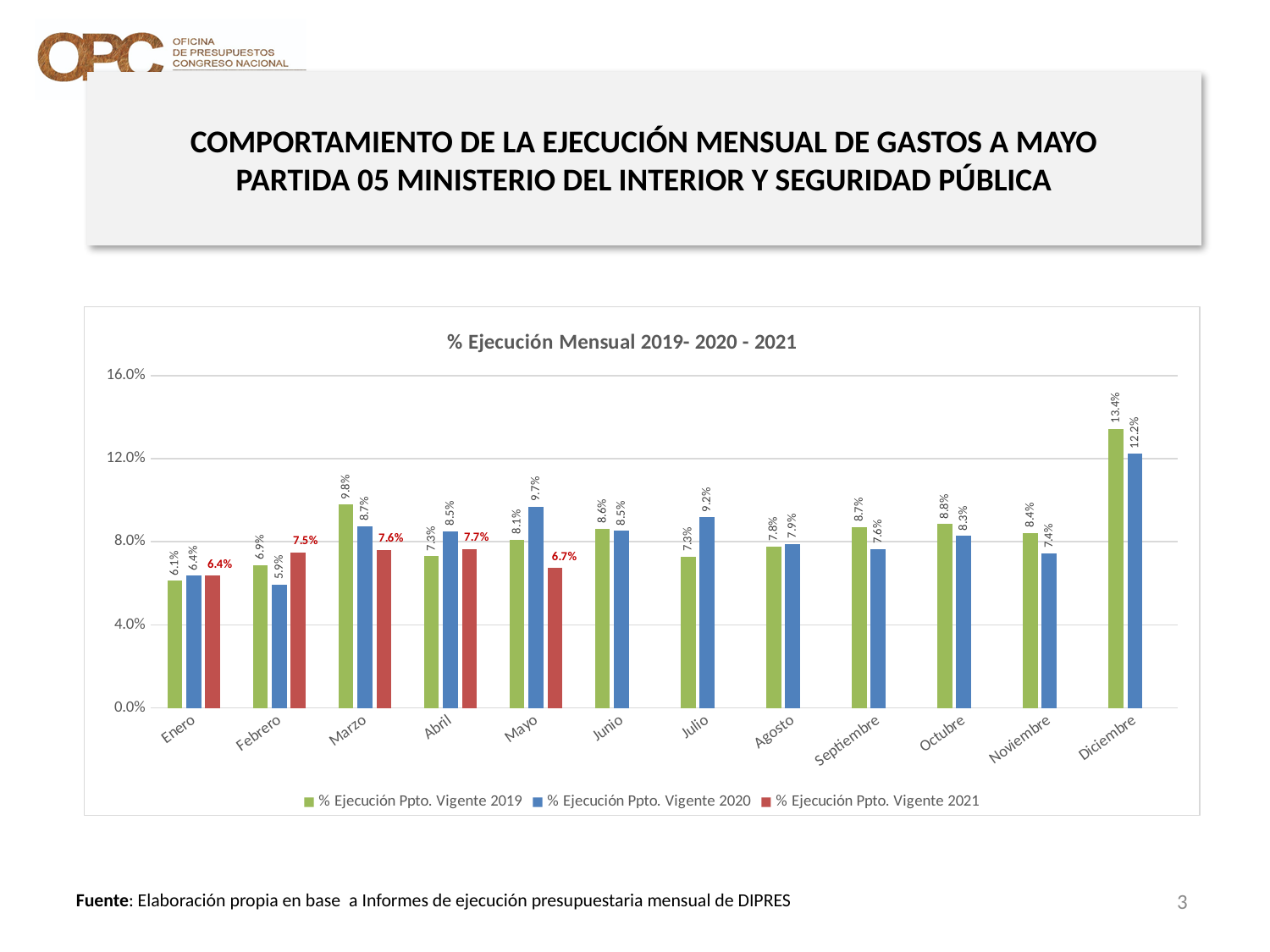
How many months are shown on the x axis? 12 How many series does the legend list? 3 What is the value for % Ejecución Ppto. Vigente 2019 in Diciembre? 13.4% Which month has the highest value for % Ejecución Ppto. Vigente 2020? Diciembre In Febrero, which is larger: the 2019 value or the 2020 value? 2019 value (6.9%) Which month has the lowest value for % Ejecución Ppto. Vigente 2021? Enero Is the value for % Ejecución Ppto. Vigente 2019 in Marzo greater or less than 8.0%? greater What is the difference between the 2019 and 2020 values in Diciembre? 1.2% What is the value for % Ejecución Ppto. Vigente 2021 in Marzo? 7.6% What type of chart is shown on the slide? bar chart What is the value for % Ejecución Ppto. Vigente 2020 in Mayo? 9.7% What is the title of the chart? % Ejecución Mensual 2019- 2020 - 2021